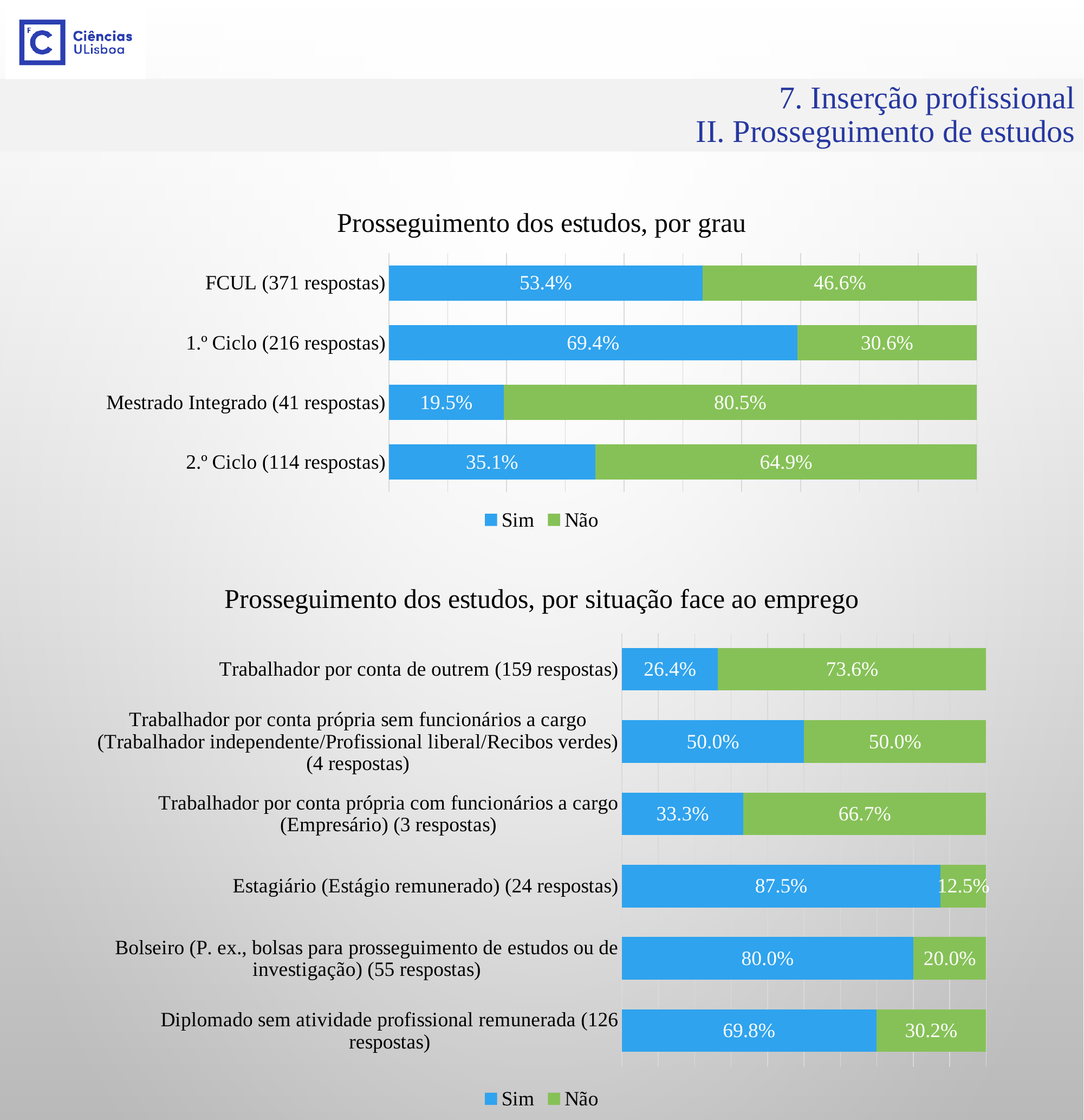
In the chart 'Prosseguimento dos estudos, por situação face ao emprego', what is the 'Sim' value for Estagiário (Estágio remunerado) (24 respostas)? 87.5% In the chart 'Prosseguimento dos estudos, por situação face ao emprego', how many series does the legend list? 2 In the chart 'Prosseguimento dos estudos, por situação face ao emprego', what is the 'Não' value for Trabalhador por conta de outrem (159 respostas)? 73.6% In the chart 'Prosseguimento dos estudos, por grau', what is the 'Sim' value for FCUL (371 respostas)? 53.4% In the chart 'Prosseguimento dos estudos, por grau', what is the 'Não' value for Mestrado Integrado (41 respostas)? 80.5% In the chart 'Prosseguimento dos estudos, por grau', how many categories are shown? 4 In the chart 'Prosseguimento dos estudos, por grau', which category has the highest 'Sim' value? 1.º Ciclo (216 respostas) In the chart 'Prosseguimento dos estudos, por grau', which category has the lowest 'Sim' value? Mestrado Integrado (41 respostas) In the chart 'Prosseguimento dos estudos, por situação face ao emprego', is the 'Sim' value larger for Bolseiro (55 respostas) or for Diplomado sem atividade profissional remunerada (126 respostas)? Bolseiro (55 respostas) In the chart 'Prosseguimento dos estudos, por grau', what is the difference between the 'Não' value for 2.º Ciclo (114 respostas) and the 'Não' value for 1.º Ciclo (216 respostas)? 34.3% What type of chart is 'Prosseguimento dos estudos, por situação face ao emprego'? Stacked bar chart In the chart 'Prosseguimento dos estudos, por situação face ao emprego', which category has the lowest 'Sim' value? Trabalhador por conta de outrem (159 respostas)